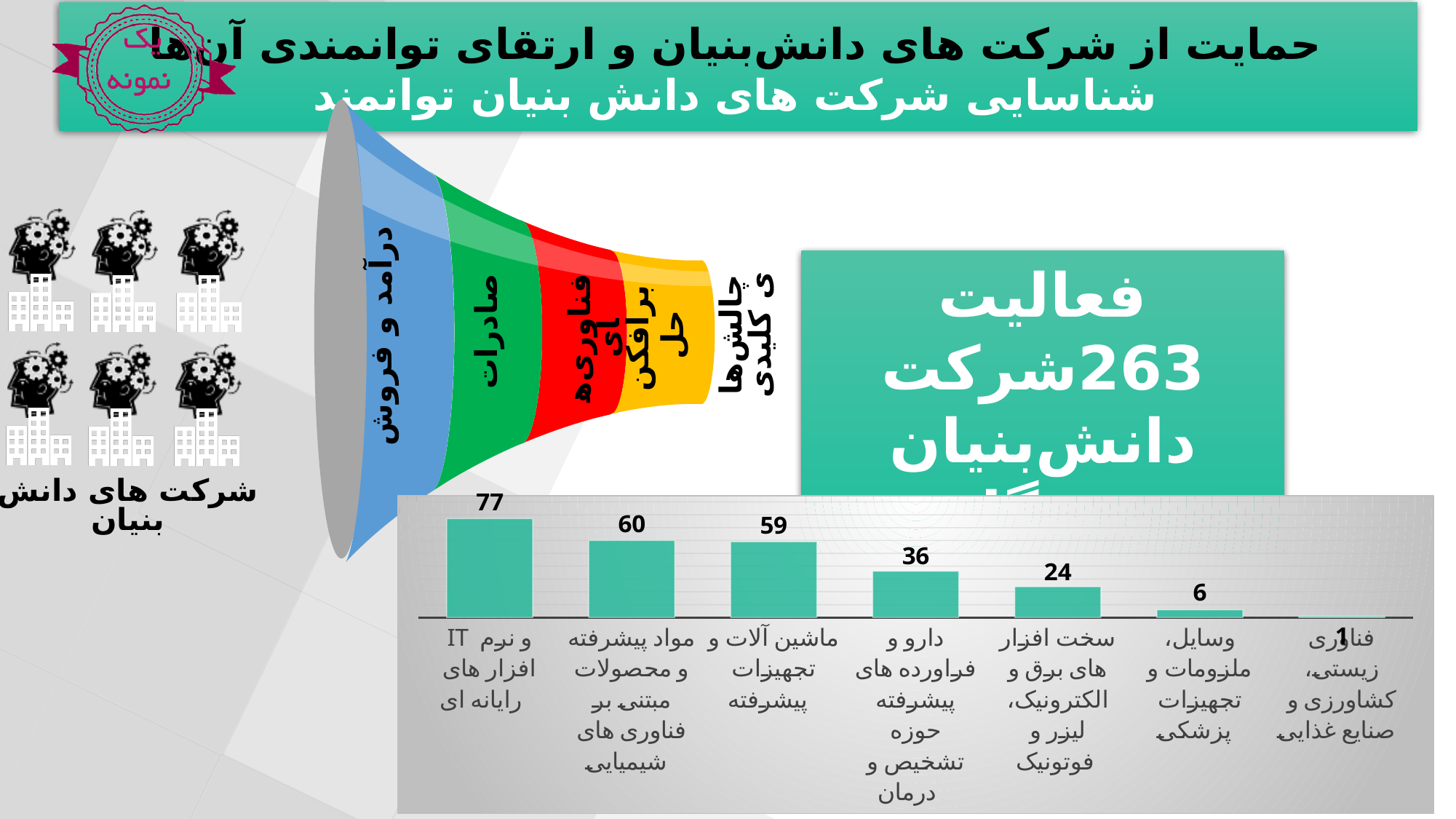
What type of chart is shown at the bottom of the slide? bar chart What is the value for "مواد پیشرفته و محصولات مبتنی بر فناوری های شیمیایی" in the bar chart? 60 Do the bar values rise or fall when reading the bar chart from left to right? fall What is the value for "وسایل، ملزومات و تجهیزات پزشکی" in the bar chart? 6 Which category has the lowest value in the bar chart? فناوری زیستی، کشاورزی و صنایع غذایی What is the difference between the values for "IT و نرم افزار های رایانه ای" and "سخت افزار های برق و الکترونیک، لیزر و فوتونیک"? 53 What is the value for the category "IT و نرم افزار های رایانه ای" in the bar chart? 77 What is the value for "دارو و فراورده های پیشرفته حوزه تشخیص و درمان" in the bar chart? 36 Which category has the highest value in the bar chart? IT و نرم افزار های رایانه ای What is the value for "ماشین آلات و تجهیزات پیشرفته" in the bar chart? 59 Which is larger in the bar chart: the value for "دارو و فراورده های پیشرفته حوزه تشخیص و درمان" or the value for "سخت افزار های برق و الکترونیک، لیزر و فوتونیک"? دارو و فراورده های پیشرفته حوزه تشخیص و درمان How many categories does the bar chart show? 7